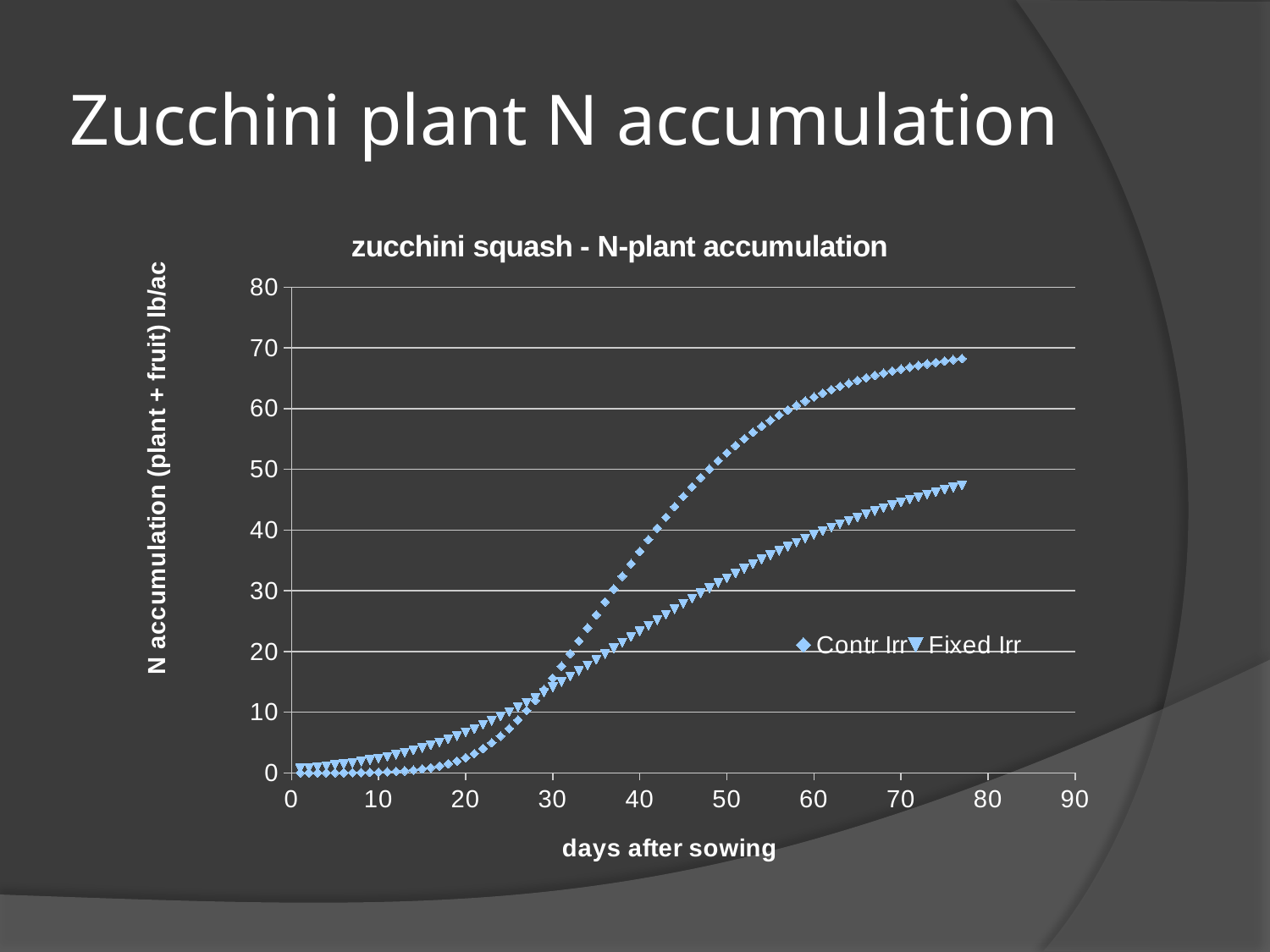
Is the Fixed Irr value at 20 days after sowing greater or less than 10? less Do the Contr Irr values rise or fall as days after sowing increase? rise What kind of chart is shown on the slide? scatter chart What is the label of the x axis? days after sowing Is the Contr Irr value at 40 days after sowing greater or less than 30? greater How many series does the legend list? 2 Is the Contr Irr value at 70 days after sowing greater or less than 60? greater Which series reaches the highest N accumulation by the end of the period? Contr Irr What is the title of the chart? zucchini squash - N-plant accumulation Which series has the higher value at 10 days after sowing, Contr Irr or Fixed Irr? Fixed Irr Which series has the higher value at 70 days after sowing, Contr Irr or Fixed Irr? Contr Irr